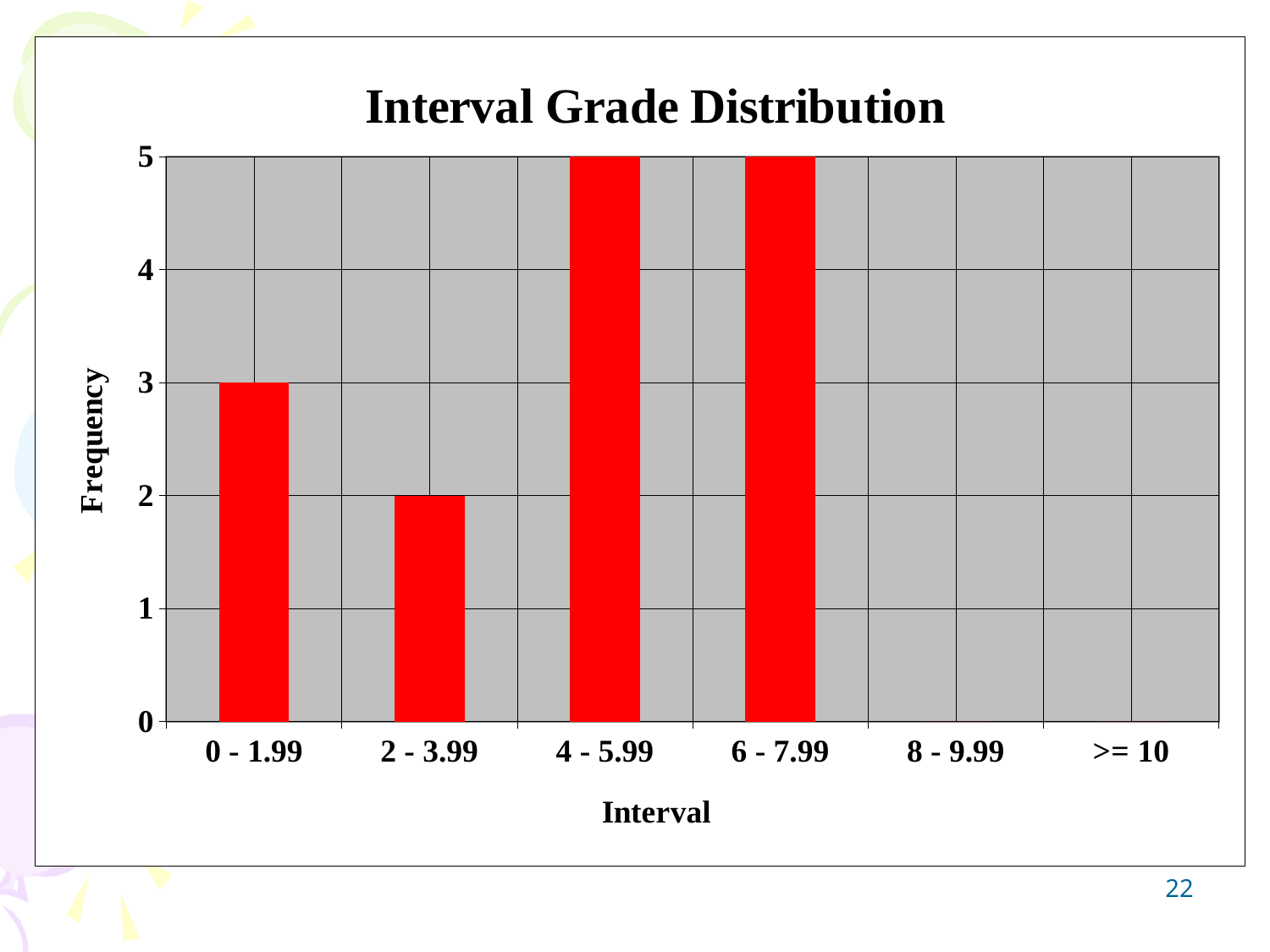
What is the frequency for the 0 - 1.99 interval? 3 What is the frequency for the 2 - 3.99 interval? 2 What is the difference in frequency between the 6 - 7.99 and 0 - 1.99 intervals? 2 What is the highest frequency value shown on the chart? 5 What is the title of the chart? Interval Grade Distribution How many intervals are shown on the x axis? 6 Which interval has a higher frequency, 0 - 1.99 or 2 - 3.99? 0 - 1.99 What is the difference in frequency between the 0 - 1.99 and 2 - 3.99 intervals? 1 What is the frequency for the 8 - 9.99 interval? 0 Is the frequency for the 0 - 1.99 interval greater or less than 4? less What kind of chart is shown on the slide? bar chart What is the frequency for the 4 - 5.99 interval? 5